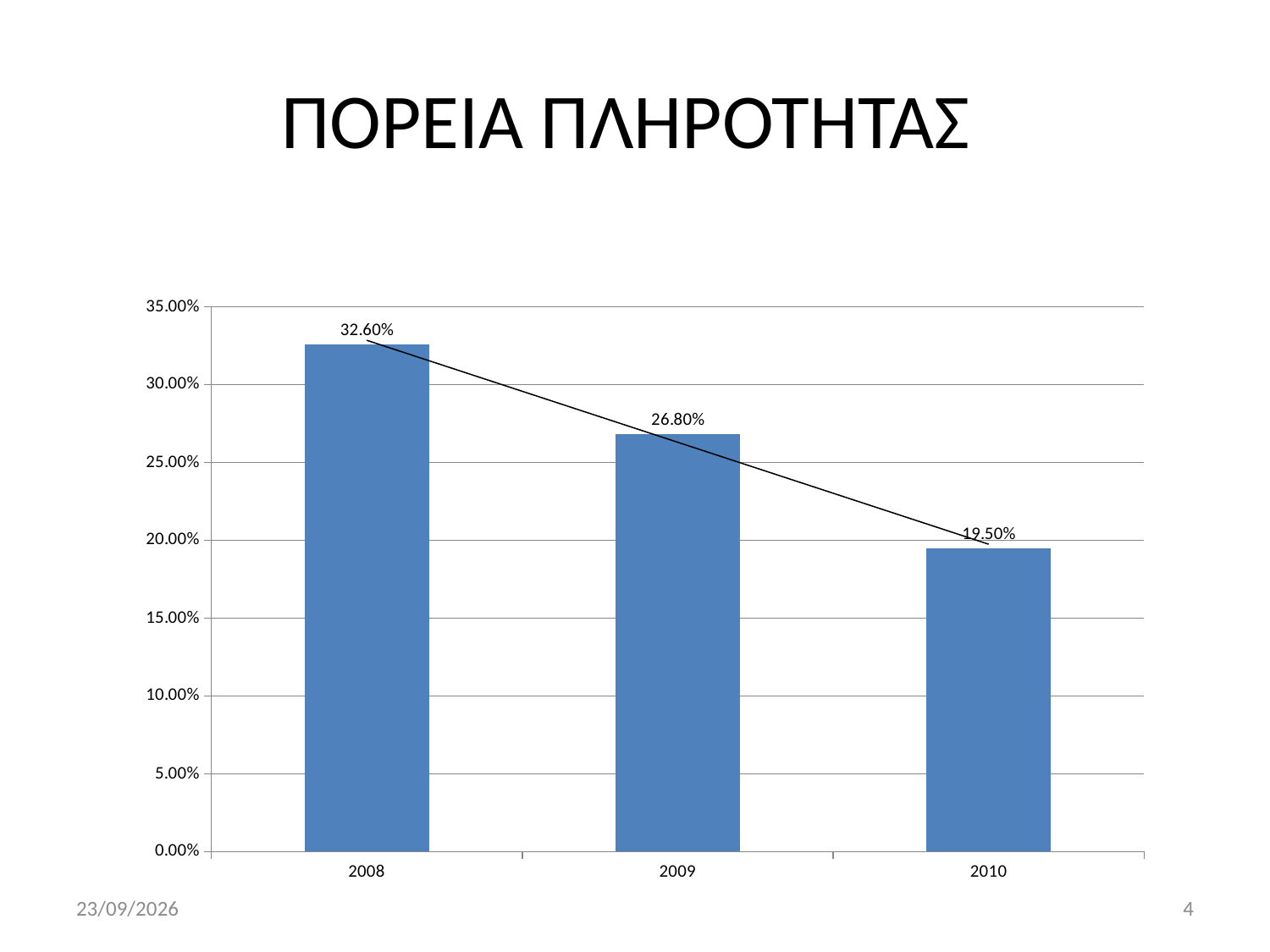
What kind of chart is shown on the slide? bar chart What is the value for 2008? 32.60% What is the value for 2009? 26.80% Which year has the lowest value? 2010 How many years are shown on the x axis? 3 Do the values rise or fall from 2008 to 2010? fall What is the difference between the values for 2008 and 2010? 13.10% What is the difference between the values for 2008 and 2009? 5.80% Which year has the highest value? 2008 What is the value for 2010? 19.50% Which is larger, the value for 2009 or the value for 2010? 2009 Is the value for 2010 greater or less than 20.00%? less